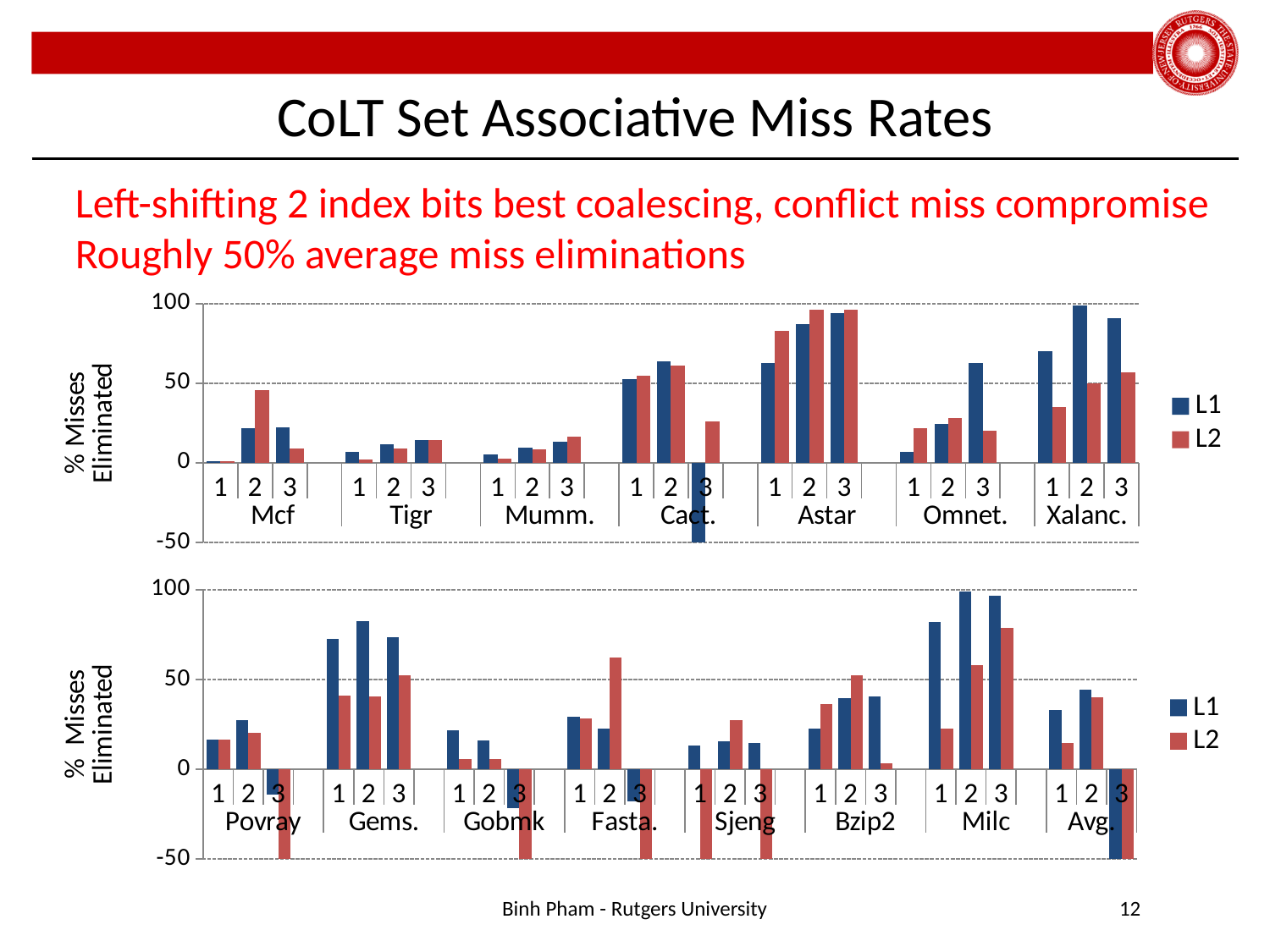
What are the two series named in the legend of the bottom chart? L1 and L2 In the top chart, is the L1 value for Astar configuration 3 greater or less than 50? greater In the top chart, is the L1 value for Tigr configuration 1 greater or less than 50? less What kind of chart is the top chart on the slide? bar chart In the bottom chart, which is larger: the L1 value for Gems. configuration 2 or the L1 value for Povray configuration 1? Gems. configuration 2 In the top chart, which configuration has the lowest L1 value? Cact. 3 In the bottom chart, is the L1 value for Milc configuration 2 greater or less than 50? greater How many benchmark groups are shown along the x axis of the bottom chart? 8 How many series does the legend of the top chart list? 2 How many benchmark groups are shown along the x axis of the top chart? 7